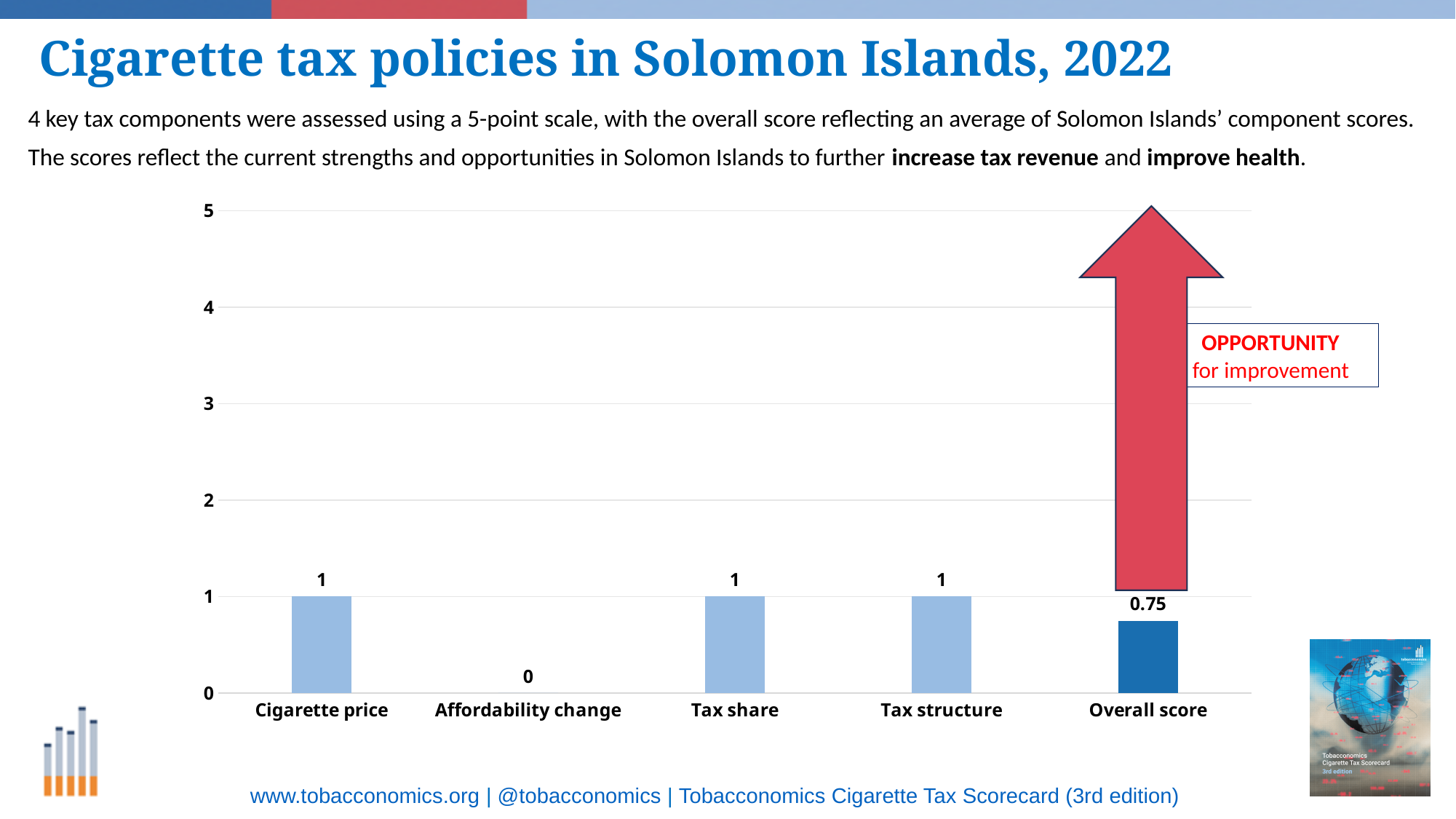
Which is larger, the value for Tax structure or the Overall score? Tax structure What is the value for Affordability change? 0 Which category has the lowest value? Affordability change What is the value for Cigarette price? 1 What is the value for Tax share? 1 What kind of chart is shown on the slide? bar chart Is the Overall score greater or less than 1? less What is the value for Tax structure? 1 What is the Overall score? 0.75 What is the difference between the value for Tax share and the Overall score? 0.25 How many categories are shown on the x axis? 5 What is the maximum value shown on the y axis? 5